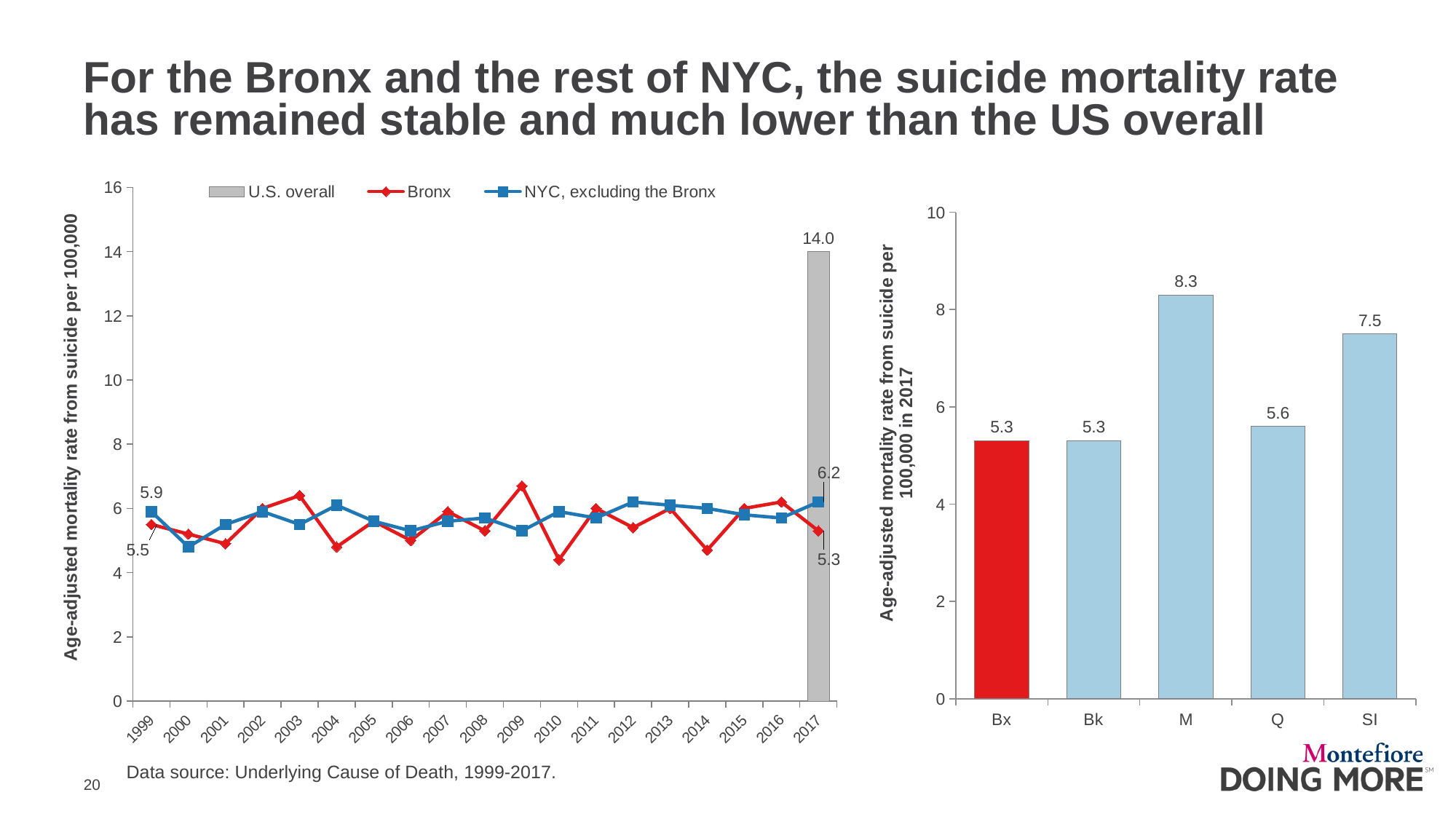
What kind of chart is the right-hand chart? Bar chart In the left-hand chart, what is the value for the Bronx in 1999? 5.5 In the right-hand bar chart, what is the difference between the values for M and Q? 2.7 In the left-hand chart, what is the value for U.S. overall in 2017? 14.0 In the right-hand bar chart, which is larger, the value for SI or the value for Bk? SI How many series does the legend of the left-hand chart list? 3 In the right-hand bar chart, which borough has the highest value? M In the right-hand bar chart, what is the value for SI? 7.5 In the left-hand chart, what is the difference between the U.S. overall value and the Bronx value in 2017? 8.7 In the right-hand bar chart, how many boroughs are shown? 5 In the right-hand bar chart, what is the value for M? 8.3 In the left-hand chart, what is the value for NYC, excluding the Bronx in 2017? 6.2